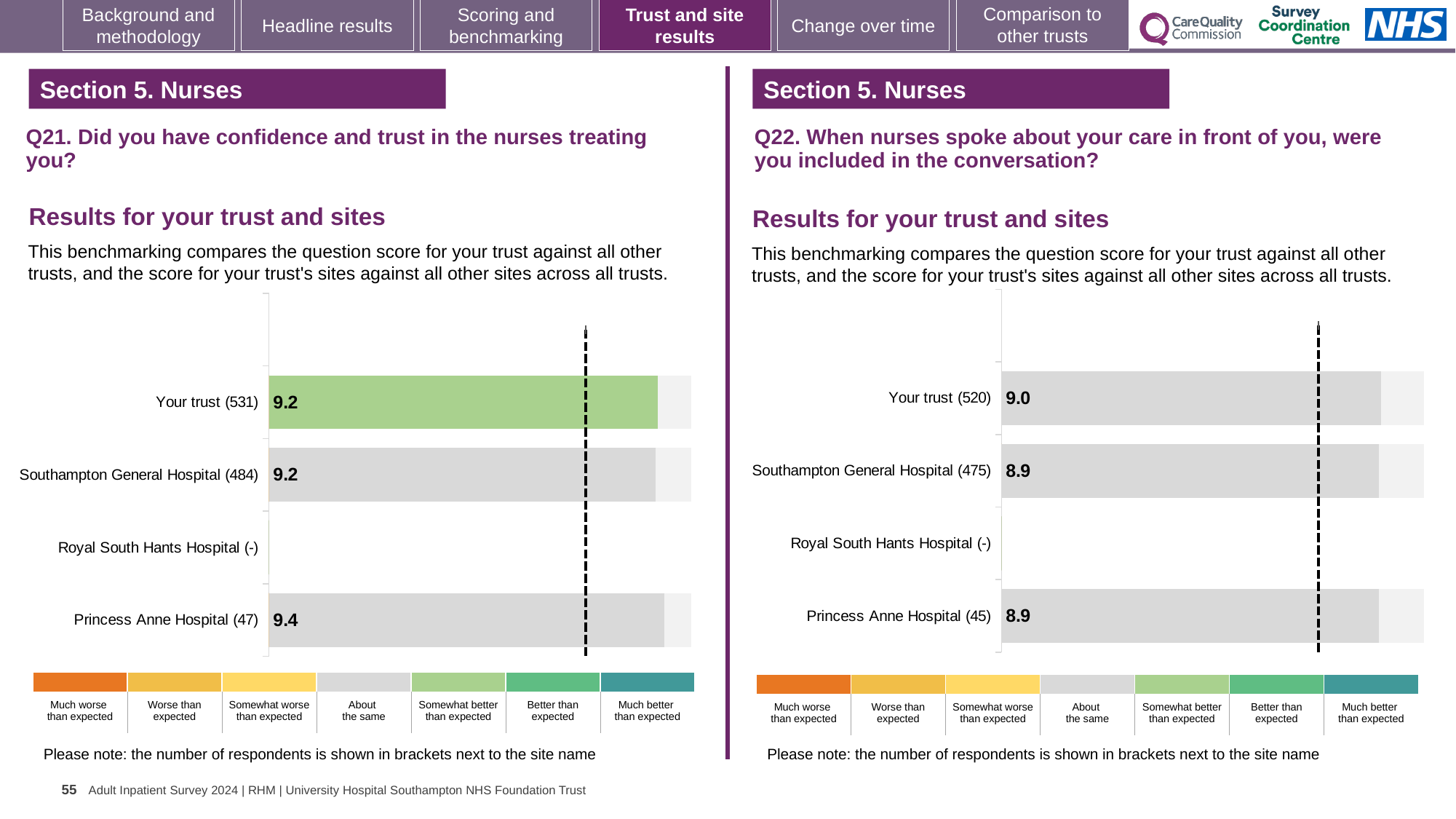
In the Q22 chart on the right, what is the score for Your trust? 9.0 In the Q22 chart on the right, what is the difference between the scores for Your trust and Southampton General Hospital? 0.1 In the Q22 chart on the right, which row has the highest score? Your trust In the Q21 chart on the left, what is the score for Princess Anne Hospital? 9.4 In the Q21 chart on the left, what is the difference between the scores for Princess Anne Hospital and Your trust? 0.2 In the Q21 chart on the left, which benchmark category does the green colour of the Your trust bar indicate? Somewhat better than expected What kind of chart is used for the Q21 results on the left? Bar chart In the Q22 chart on the right, which has the larger score, Your trust or Princess Anne Hospital? Your trust How many rows (trust and sites) are listed in the Q21 chart on the left? 4 In the Q21 chart on the left, what is the score for Your trust? 9.2 In the Q22 chart on the right, what is the score for Southampton General Hospital? 8.9 In the Q21 chart on the left, which site or trust has the highest score? Princess Anne Hospital